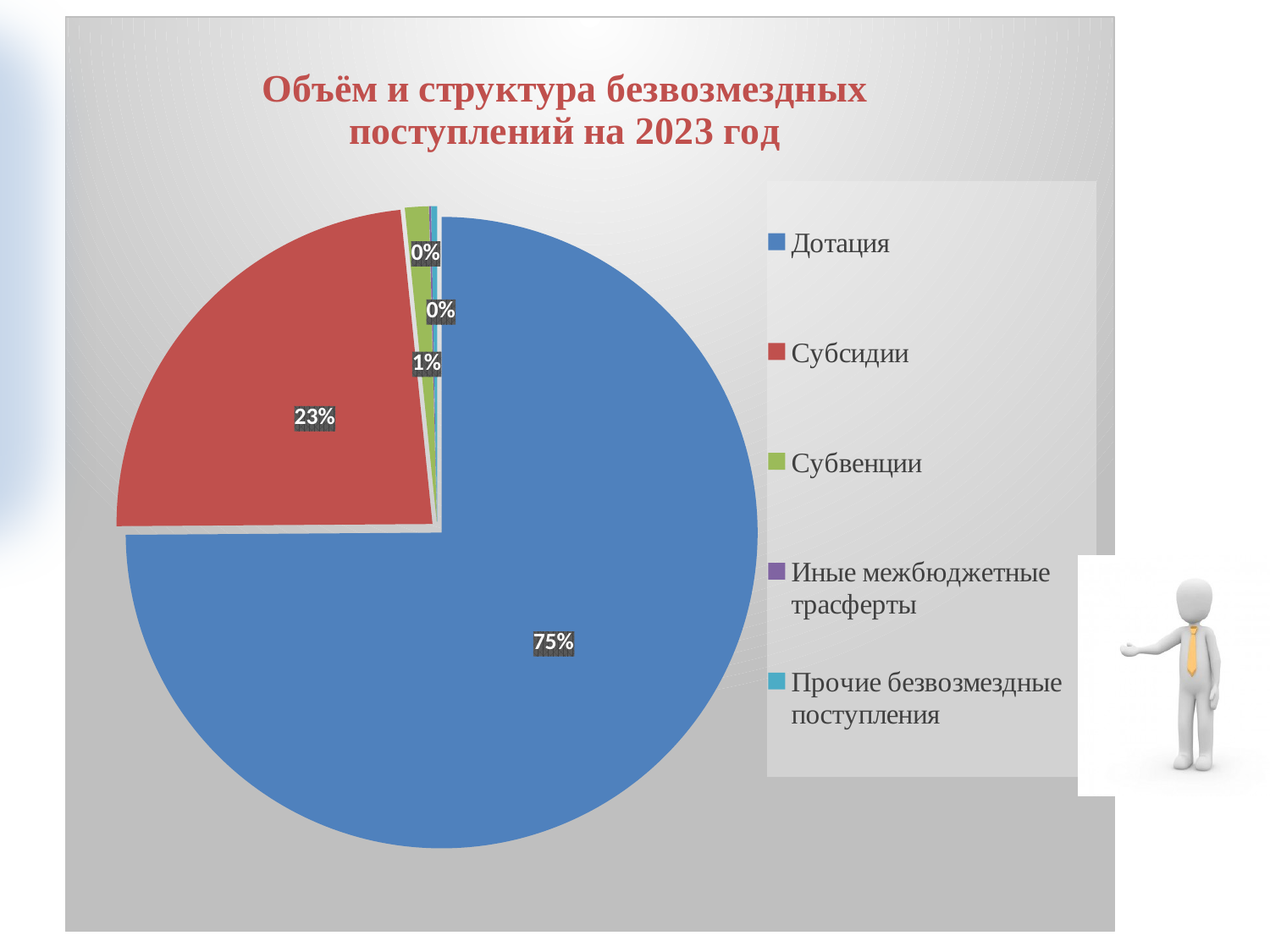
What share of the pie does Дотация account for? 75% Which is larger, the share for Субсидии or the share for Субвенции? Субсидии What percentage is shown for Субвенции? 1% Is the share for Дотация greater or less than 50%? greater How many categories does the legend list? 5 What kind of chart is shown on the slide? pie chart What is the title of the chart? Объём и структура безвозмездных поступлений на 2023 год Which category has the largest slice of the pie? Дотация What percentage is shown for Субсидии? 23% What colour is the slice for Дотация? blue What is the combined share of Дотация and Субсидии? 98% What is the difference in percentage points between Дотация and Субсидии? 52%